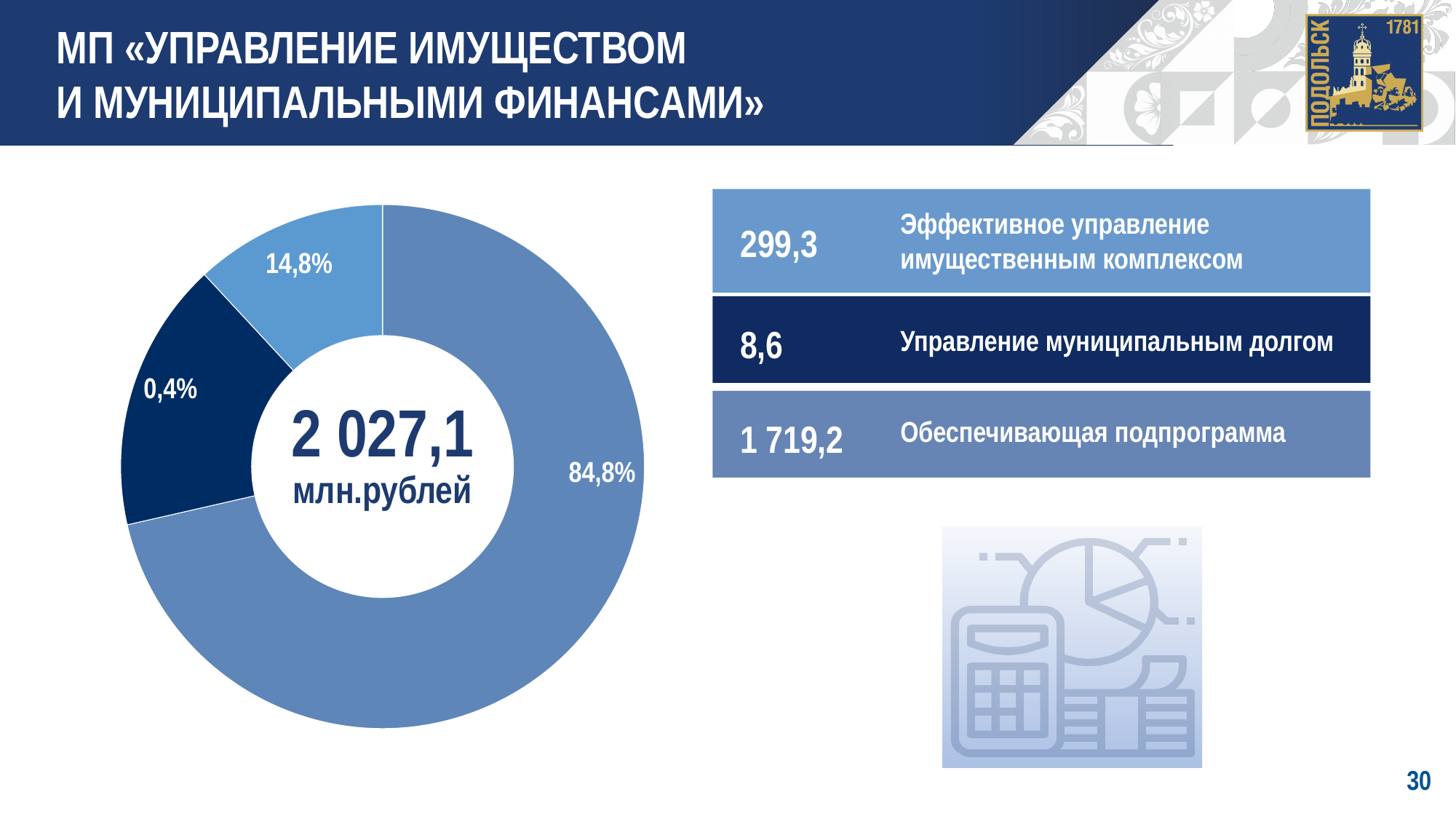
Which subprogramme has the smallest value? Управление муниципальным долгом How many slices does the donut chart have? 3 What share of the donut chart does the slice for «Обеспечивающая подпрограмма» take? 84,8% What kind of chart is shown on the slide? Donut (pie) chart Which is larger: the value for «Эффективное управление имущественным комплексом» or for «Управление муниципальным долгом»? Эффективное управление имущественным комплексом What is the value shown for «Управление муниципальным долгом»? 8,6 What is the value shown for «Эффективное управление имущественным комплексом»? 299,3 What share of the donut chart does the slice for «Управление муниципальным долгом» take? 0,4% What total value is printed in the centre of the donut chart? 2 027,1 млн.рублей What share of the donut chart does the slice for «Эффективное управление имущественным комплексом» take? 14,8% What is the difference between the values for «Обеспечивающая подпрограмма» and «Эффективное управление имущественным комплексом»? 1 419,9 Which subprogramme has the largest value? Обеспечивающая подпрограмма